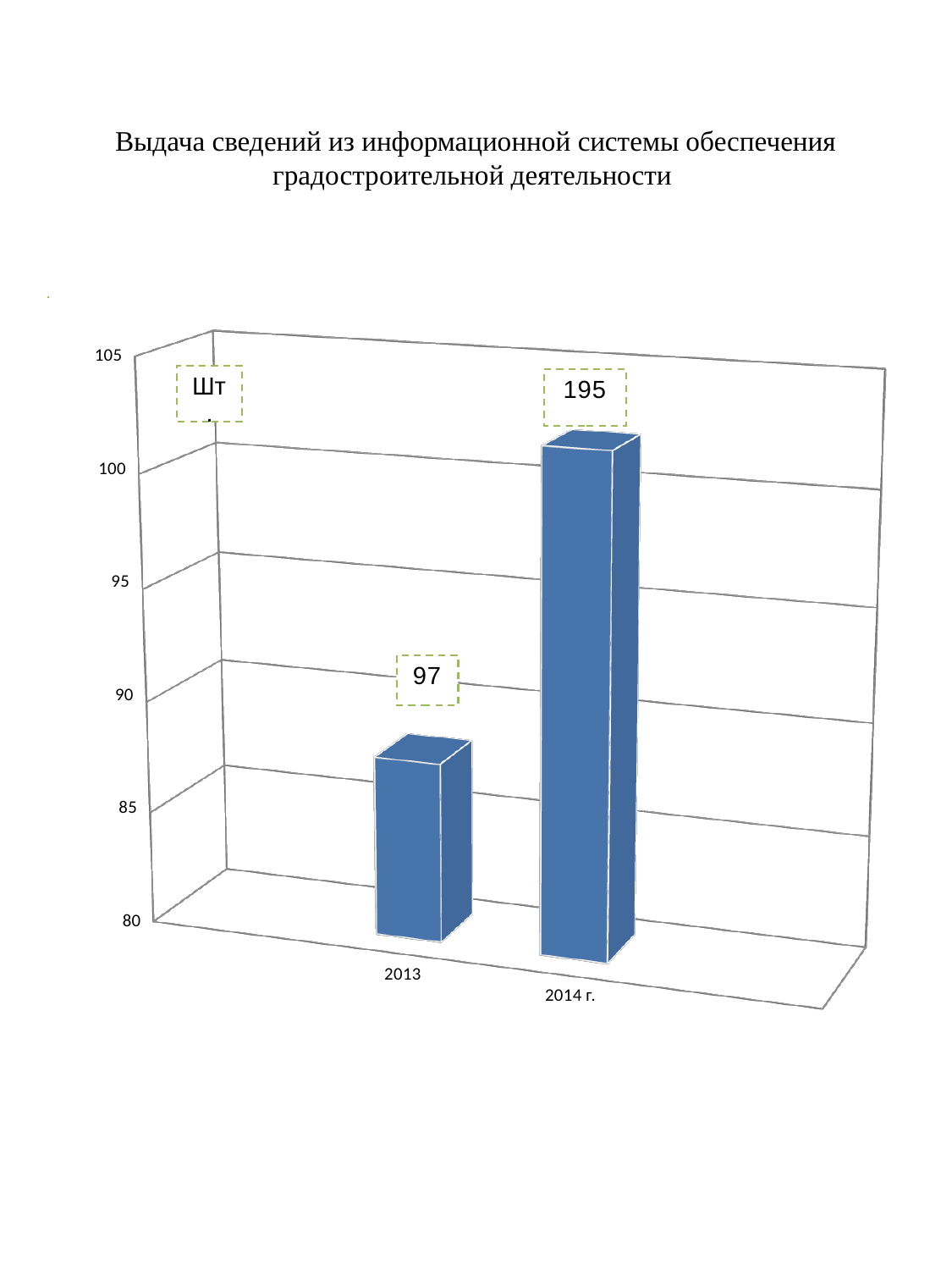
What unit label is shown in the top-left corner of the plot area? Шт How many bars are plotted on the chart? 2 What value is shown for 2013? 97 Do the values rise or fall from 2013 to 2014 г.? Rise What is the difference between the values for 2014 г. and 2013? 98 Which is larger, the value for 2013 or the value for 2014 г.? 2014 г. Which year has the highest value? 2014 г. What kind of chart is shown on the slide? Bar chart What is the title of the chart? Выдача сведений из информационной системы обеспечения градостроительной деятельности Which year has the lowest value? 2013 What value is shown for 2014 г.? 195